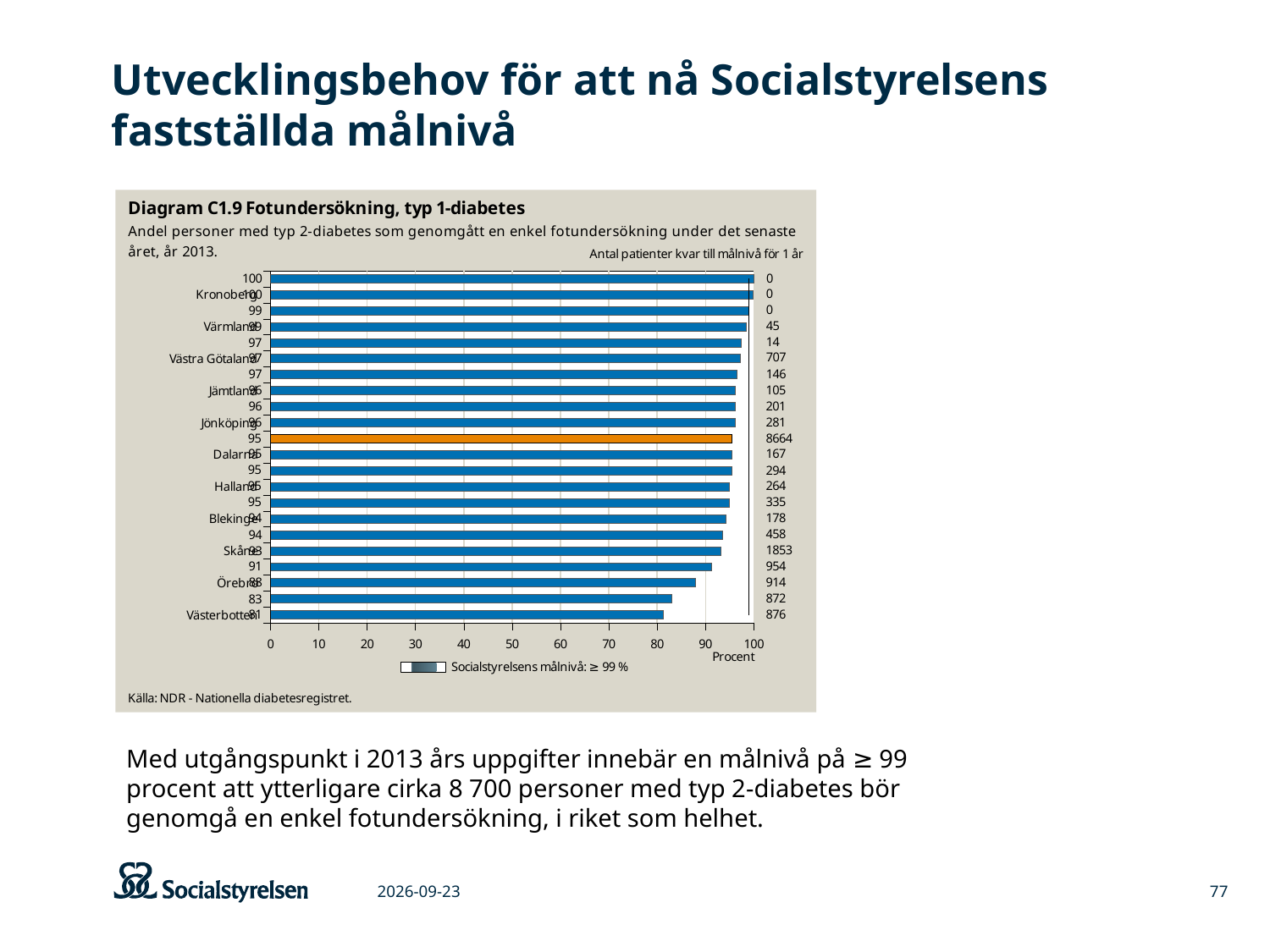
What is the value (percent) for Skåne? 93 What is the value (percent) for Västerbotten? 81 What is the value (percent) for Örebro? 88 What is the difference in percent between Kronoberg and Västerbotten? 19 Which region has the lowest value in the chart? Västerbotten What is the value (percent) for Värmland? 99 What is the title of the diagram? Diagram C1.9 Fotundersökning, typ 1-diabetes Which has a higher value, Örebro or Skåne? Skåne What is the difference in percent between Jämtland and Blekinge? 2 What kind of chart is shown on the slide? bar chart According to the right-hand column, how many patients remain to reach the target level for Skåne? 1853 How many bars are plotted in the chart? 22